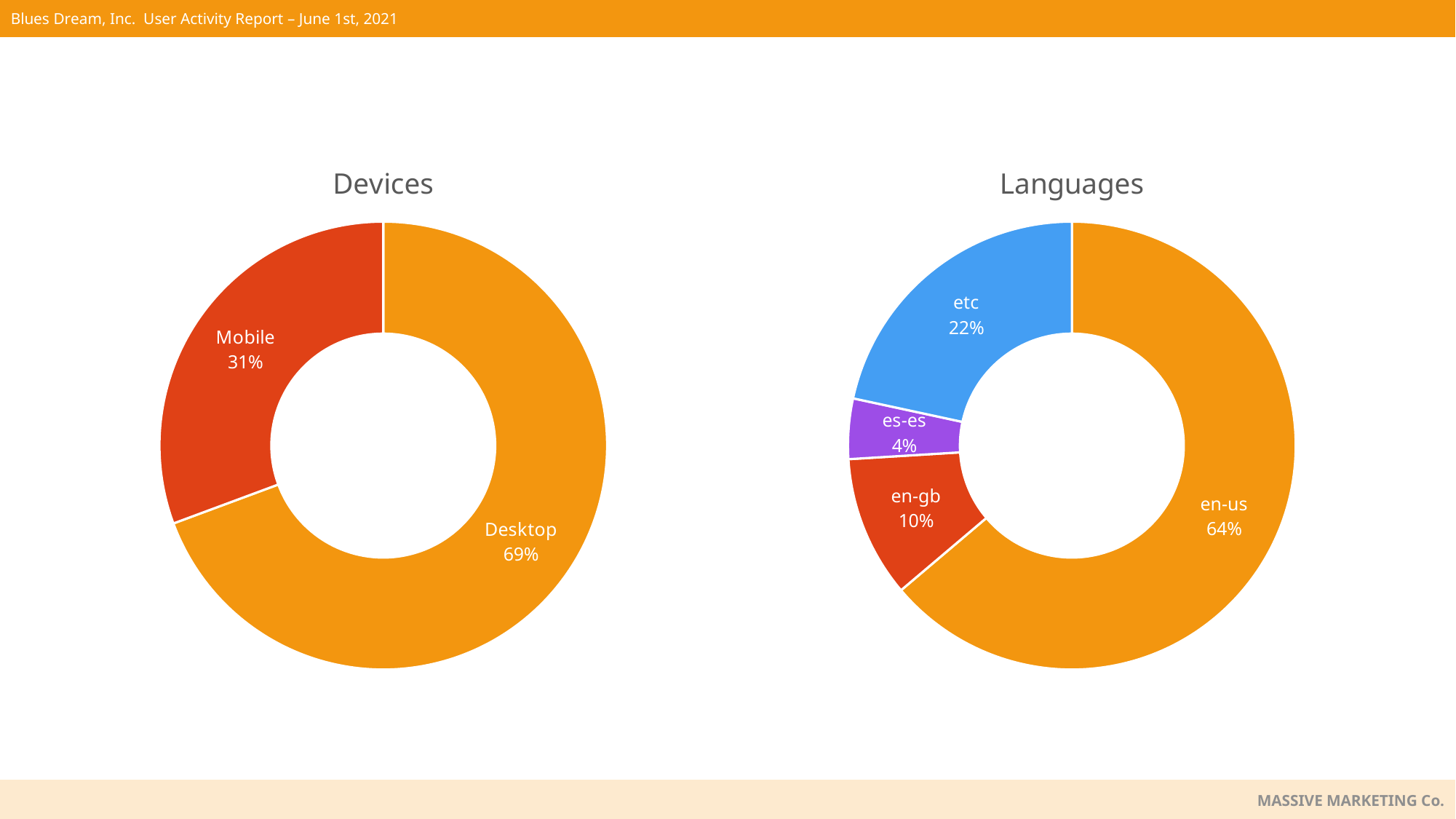
In the Devices chart, how many slices are there? 2 In the Devices chart, which device has the larger share? Desktop In the Devices chart, what share of users are on Desktop? 69% In the Languages chart, what share is en-us? 64% In the Languages chart, which is larger, etc or en-gb? etc In the Languages chart, which language has the largest share? en-us In the Languages chart, what share is en-gb? 10% What type of chart is the Languages chart? Doughnut (pie) chart In the Devices chart, what is the difference in percentage points between Desktop and Mobile? 38 In the Languages chart, which language has the smallest share? es-es In the Devices chart, what share of users are on Mobile? 31% In the Languages chart, how many slices are there? 4